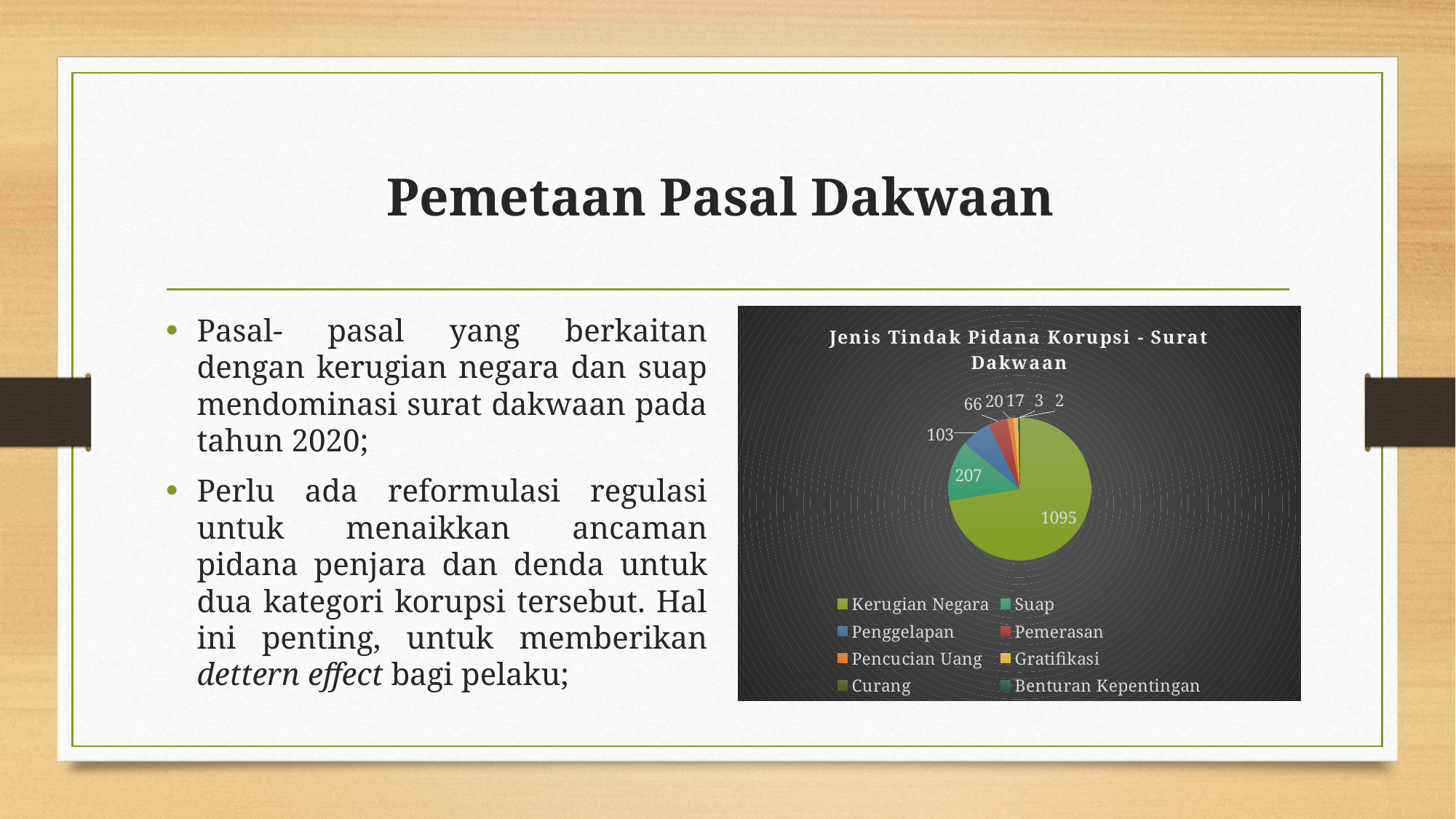
What is the value for Suap? 207 What is the value for Kerugian Negara? 1095 Which category has the smallest slice of the pie? Benturan Kepentingan What is the difference between the values for Kerugian Negara and Suap? 888 Which is larger, the value for Suap or the value for Penggelapan? Suap What is the value for Pemerasan? 66 How many categories does the legend list? 8 What is the total of all the values shown in the pie chart? 1513 What is the title of the chart? Jenis Tindak Pidana Korupsi - Surat Dakwaan What type of chart is shown on the slide? pie chart What is the value for Penggelapan? 103 Which category has the largest slice of the pie? Kerugian Negara